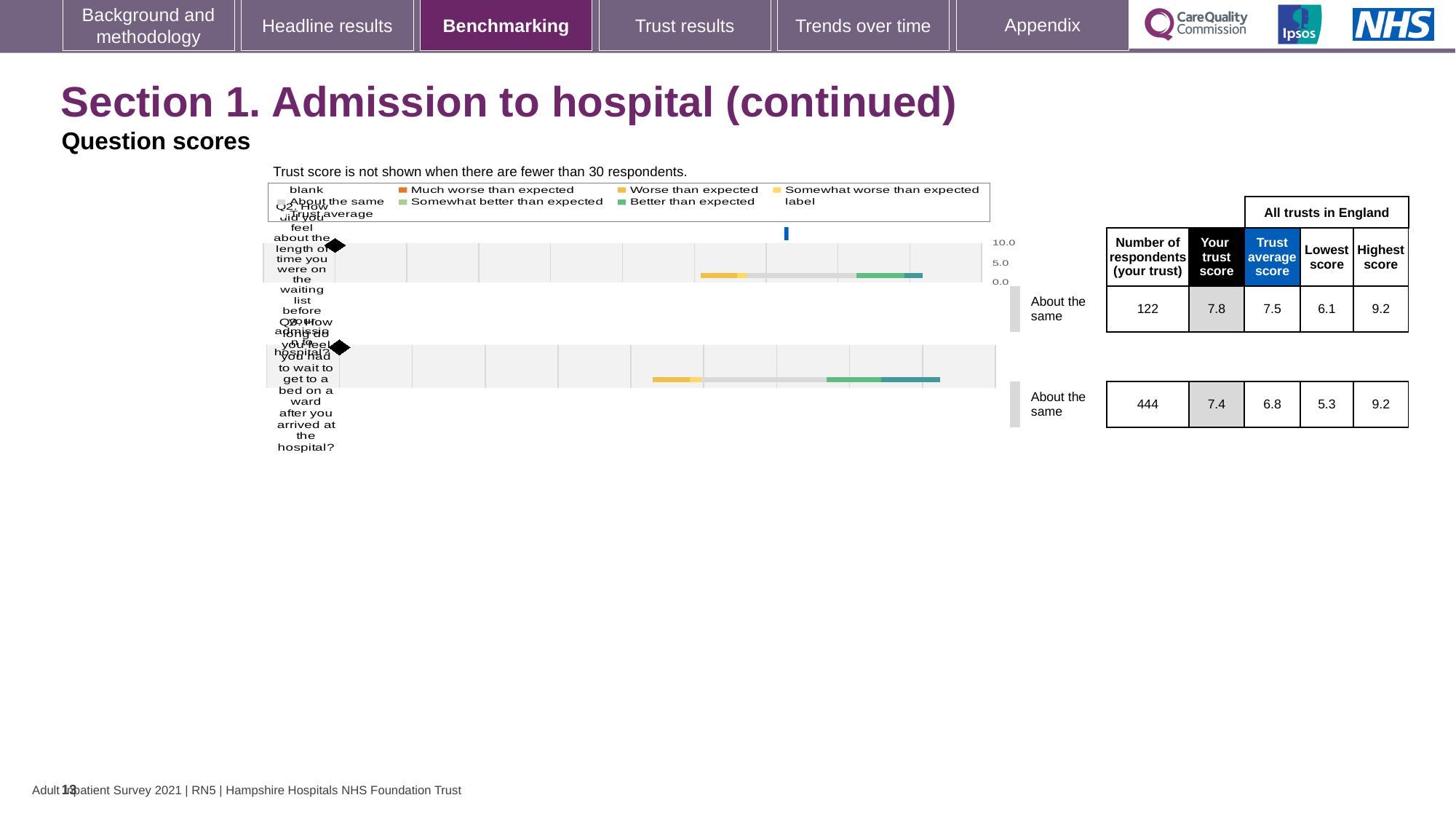
What is the trust score for Q3 (how long did you feel you had to wait to get to a bed on a ward)? 7.4 How many respondents answered Q3 for this trust? 444 What is the trust score for Q2 (how did you feel about the length of time on the waiting list)? 7.8 Is the trust score for Q2 greater or less than 5.0 on the axis? greater What is the lowest score across all trusts in England for Q2? 6.1 What benchmark category is shown for Q3? About the same Which question has the higher trust score, Q2 or Q3? Q2 How many questions are plotted on the slide? 2 What is the trust average score for Q3? 6.8 What kind of chart is used to show the question scores on this slide? bar chart What is the difference between the trust score and the trust average score for Q3? 0.6 What is the difference between the highest and lowest scores for Q2? 3.1